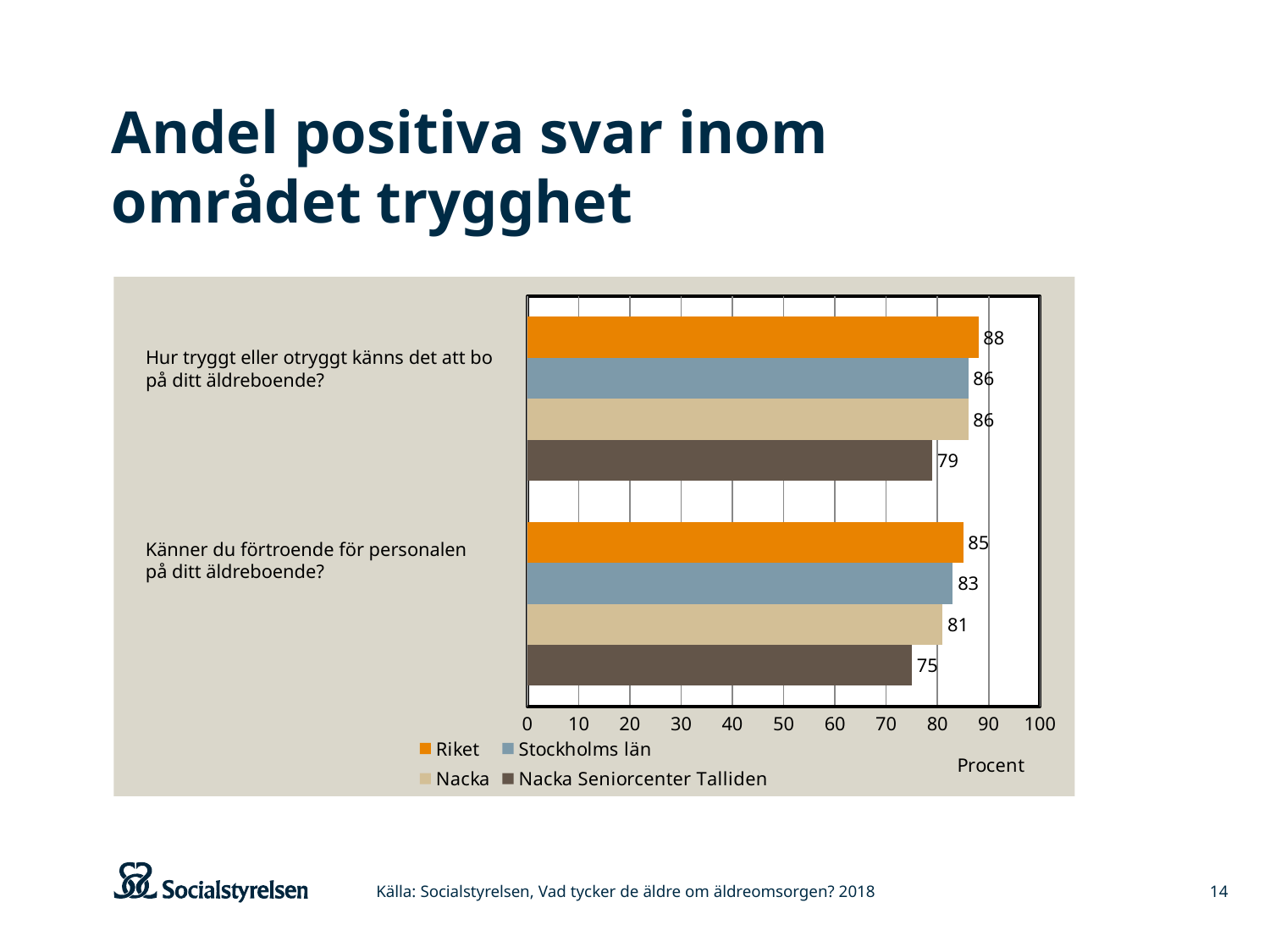
How many series does the legend list? 4 Is the value for Nacka Seniorcenter Talliden for "Känner du förtroende för personalen på ditt äldreboende?" greater or less than 80? less What is the difference between Riket and Nacka for the question "Hur tryggt eller otryggt känns det att bo på ditt äldreboende?"? 2 What is the difference between Riket and Nacka Seniorcenter Talliden for the question "Känner du förtroende för personalen på ditt äldreboende?"? 10 What unit is shown on the horizontal axis label? Procent Which series has the highest value for the question "Känner du förtroende för personalen på ditt äldreboende?"? Riket Which series has the lowest value for the question "Hur tryggt eller otryggt känns det att bo på ditt äldreboende?"? Nacka Seniorcenter Talliden What kind of chart is shown on the slide? Bar chart Which is larger: the Nacka value for "Hur tryggt eller otryggt känns det att bo på ditt äldreboende?" or the Nacka value for "Känner du förtroende för personalen på ditt äldreboende?"? Hur tryggt eller otryggt känns det att bo på ditt äldreboende? What is the value for Riket for the question "Hur tryggt eller otryggt känns det att bo på ditt äldreboende?"? 88 What is the value for Stockholms län for the question "Känner du förtroende för personalen på ditt äldreboende?"? 83 What is the value for Nacka Seniorcenter Talliden for the question "Känner du förtroende för personalen på ditt äldreboende?"? 75